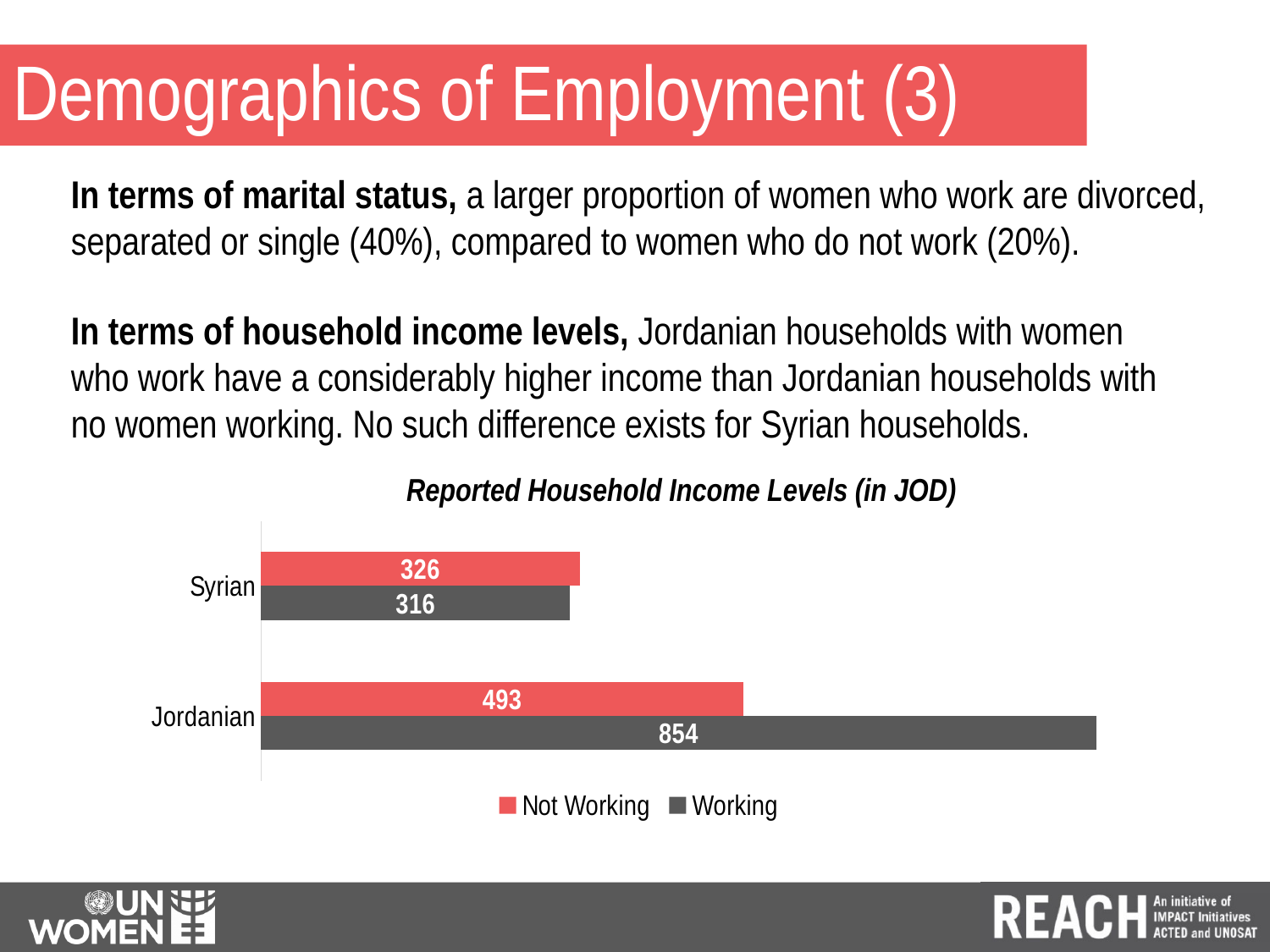
What is the reported household income for Jordanian households with women working? 854 What is the difference between the Not Working and Working income values for Syrian households? 10 Which is larger for Jordanian households: the Working or the Not Working income value? Working Which bar in the chart has the highest value? Jordanian, Working How many nationality categories are shown in the chart? 2 What is the reported household income for Jordanian households with women not working? 493 Which bar in the chart has the lowest value? Syrian, Working What type of chart is shown on the slide? Bar chart What is the reported household income for Syrian households with women working? 316 How many series does the legend list? 2 What is the reported household income for Syrian households with women not working? 326 What is the difference between the Working and Not Working income values for Jordanian households? 361